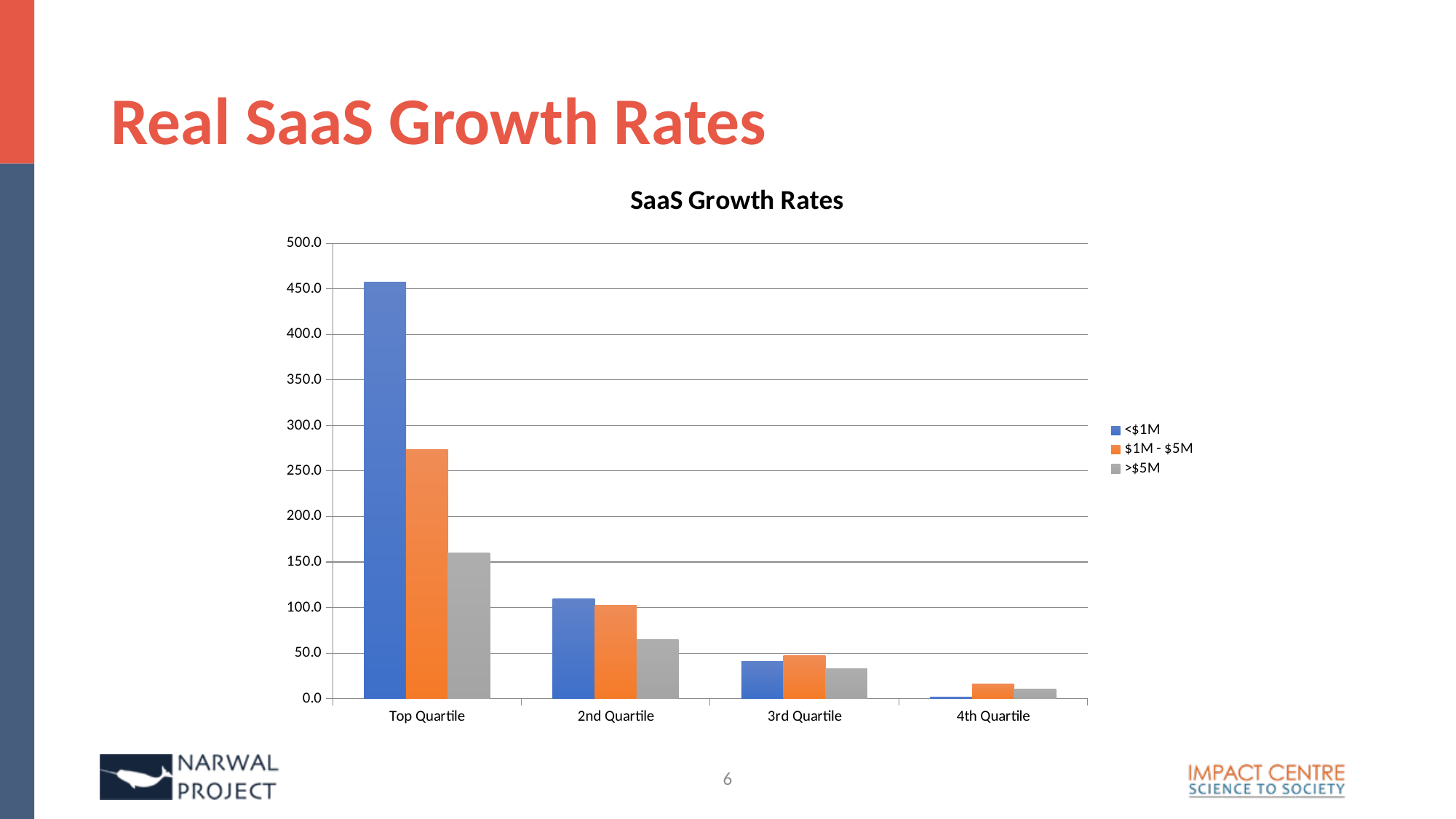
Is the value for $1M - $5M in the Top Quartile greater or less than 250? greater In the 3rd Quartile, which is larger: the <$1M value or the $1M - $5M value? $1M - $5M Is the value for <$1M in the 3rd Quartile greater or less than 50? less What is the title of the chart? SaaS Growth Rates How many series does the legend list? 3 Do the values for the <$1M series rise or fall from Top Quartile to 4th Quartile? fall Which category has the highest value for the <$1M series? Top Quartile What kind of chart is shown on the slide? bar chart Is the value for <$1M in the Top Quartile greater or less than 400? greater Which category has the lowest value for the <$1M series? 4th Quartile How many quartile categories are shown on the x axis? 4